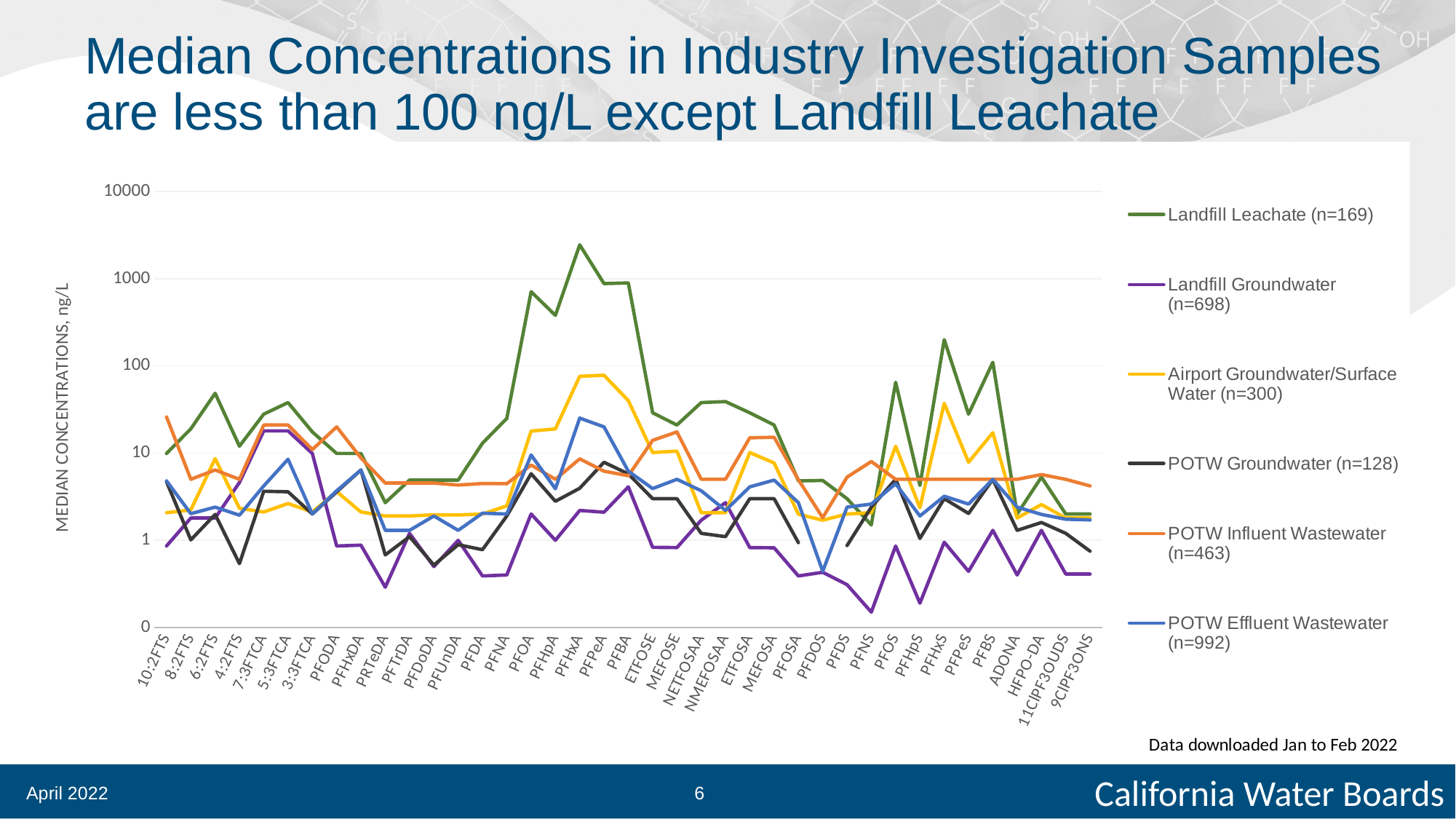
How many series does the legend list? 6 Which series has the highest value at PFHxA? Landfill Leachate (n=169) Is the Landfill Leachate value for PFHxA greater or less than 1000? greater Is the POTW Influent Wastewater value for 10:2FTS greater or less than 10? greater What is the title of the chart's y axis? MEDIAN CONCENTRATIONS, ng/L Which series has the lowest value at PFNS? Landfill Groundwater (n=698) At PFOA, which is larger: the Landfill Leachate value or the Airport Groundwater/Surface Water value? Landfill Leachate What kind of chart is shown on the slide? line chart How many compounds (categories) are plotted along the x axis? 39 Is the Landfill Leachate value for PFOA greater or less than 100? greater According to the legend, what is the sample count (n) for POTW Effluent Wastewater? 992